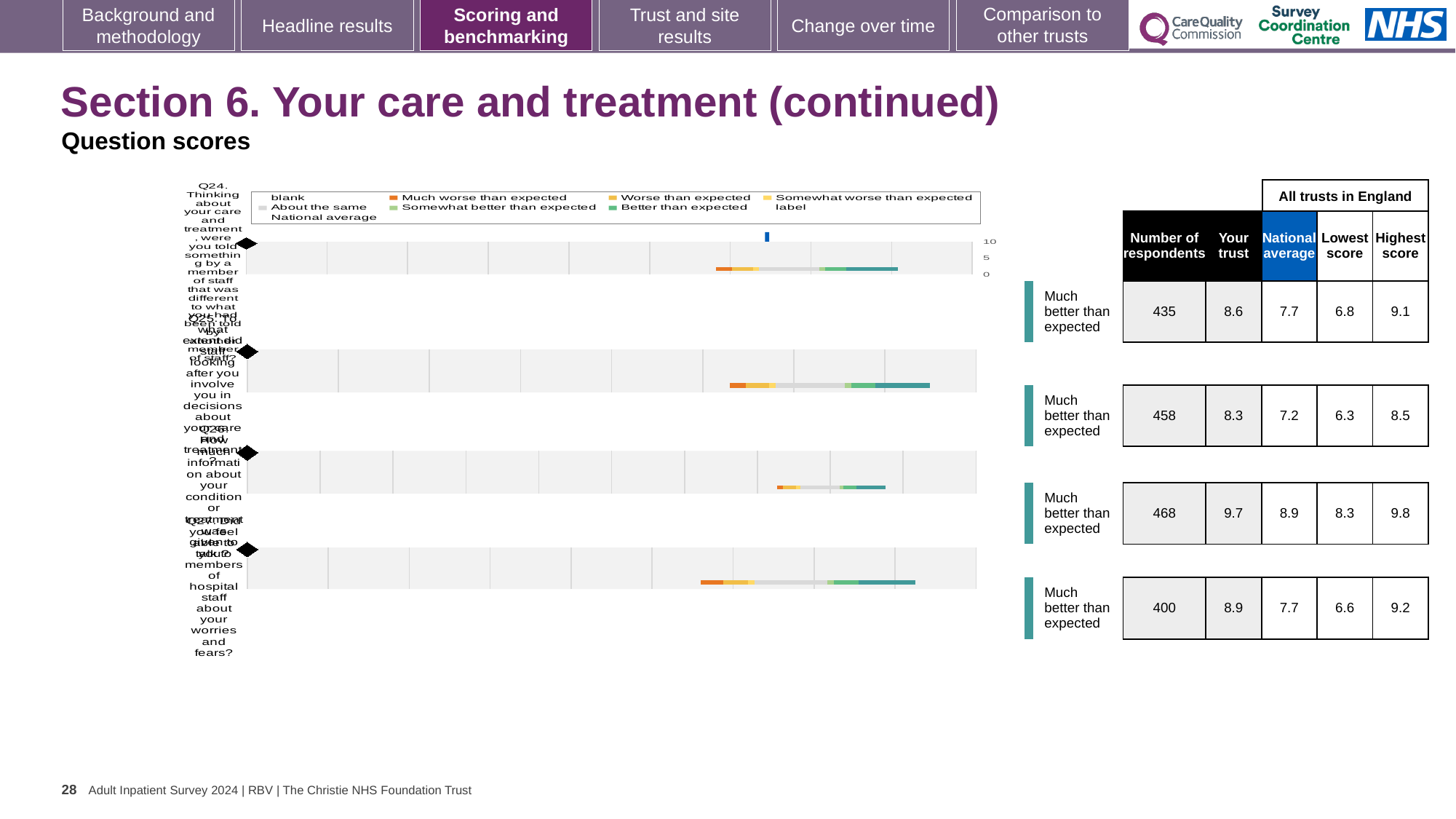
Which legend entry is shown in orange-red in the chart's legend? Much worse than expected How many of the four question rows are labelled 'Much better than expected'? 4 In the table beside the chart, what is the highest score among all trusts in England for the second row (Q25)? 8.5 How many question rows (Q24 to Q27) does the chart show? 4 In the table beside the chart, how many respondents are listed for the third row (Q26)? 468 What kind of chart is shown on the slide? bar chart In the table beside the chart, for the fourth row (Q27), which is larger: the 'Your trust' score or the national average? Your trust (8.9) In the table beside the chart, which row has the highest 'Your trust' score? Q26 (9.7) In the table beside the chart, what is the difference between the 'Your trust' score and the national average for the first row (Q24)? 0.9 What is the highest tick value shown on the chart's score axis? 10 In the table beside the chart, which row has the lowest national average? Q25 (7.2) In the table beside the chart, what is the 'Your trust' score for the first row (Q24)? 8.6